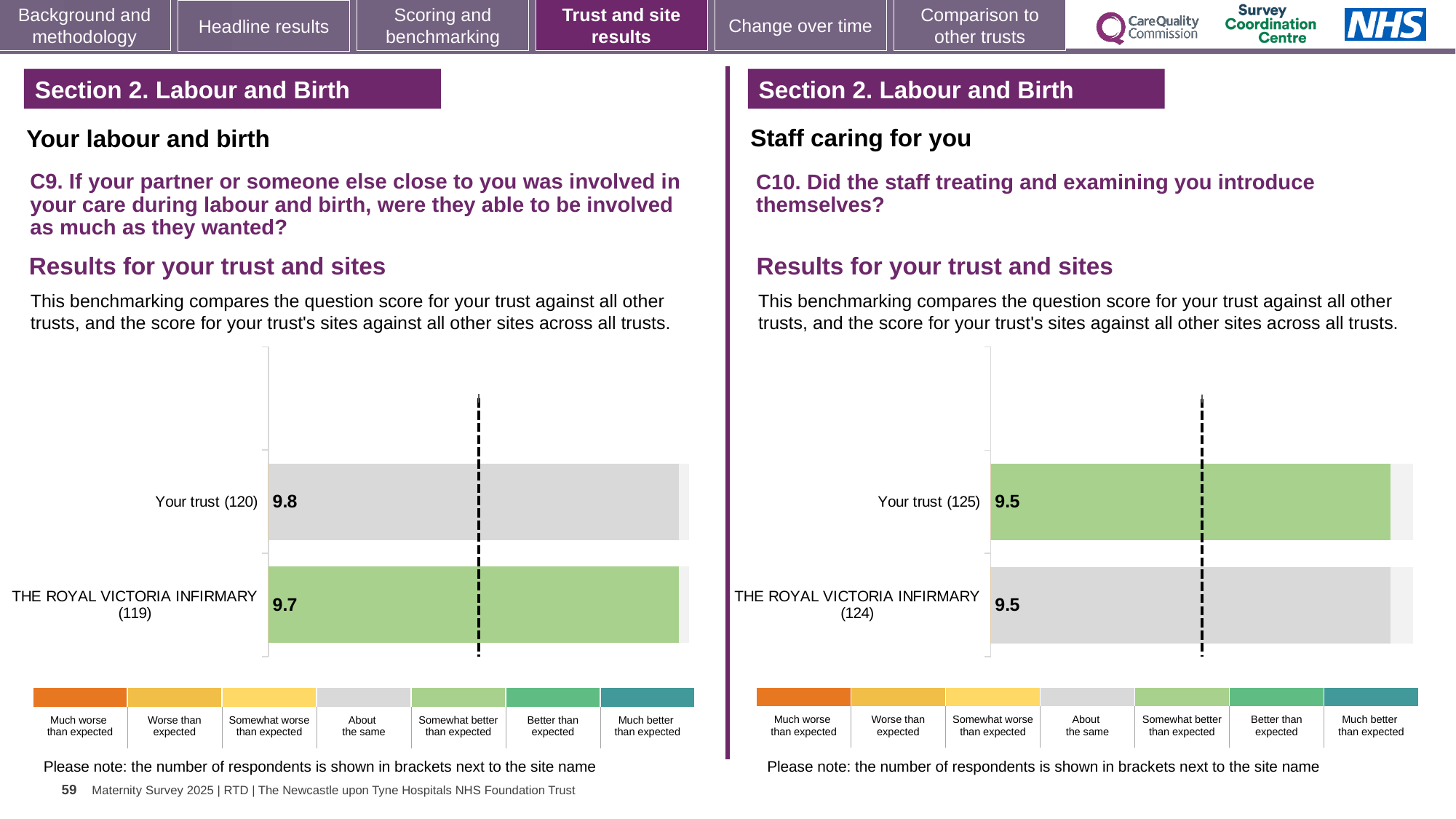
On the left chart (C9), what is the difference between the score for Your trust and the score for THE ROYAL VICTORIA INFIRMARY? 0.1 On the left chart (C9), which has the higher score, Your trust or THE ROYAL VICTORIA INFIRMARY? Your trust On the right chart (C10), what is the difference between the score for Your trust and the score for THE ROYAL VICTORIA INFIRMARY? 0 On the left chart (C9), what is the score for Your trust (120)? 9.8 On the right chart (C10), what is the score for Your trust (125)? 9.5 On the right chart (C10), which benchmark category does the colour of the Your trust bar correspond to? Somewhat better than expected How many bars are plotted on the right chart (C10)? 2 What type of chart is used on the left (C9)? Bar chart How many bars are plotted on the left chart (C9)? 2 On the left chart (C9), what is the score for THE ROYAL VICTORIA INFIRMARY (119)? 9.7 On the left chart (C9), which benchmark category does the colour of the THE ROYAL VICTORIA INFIRMARY bar correspond to? Somewhat better than expected On the right chart (C10), what is the score for THE ROYAL VICTORIA INFIRMARY (124)? 9.5